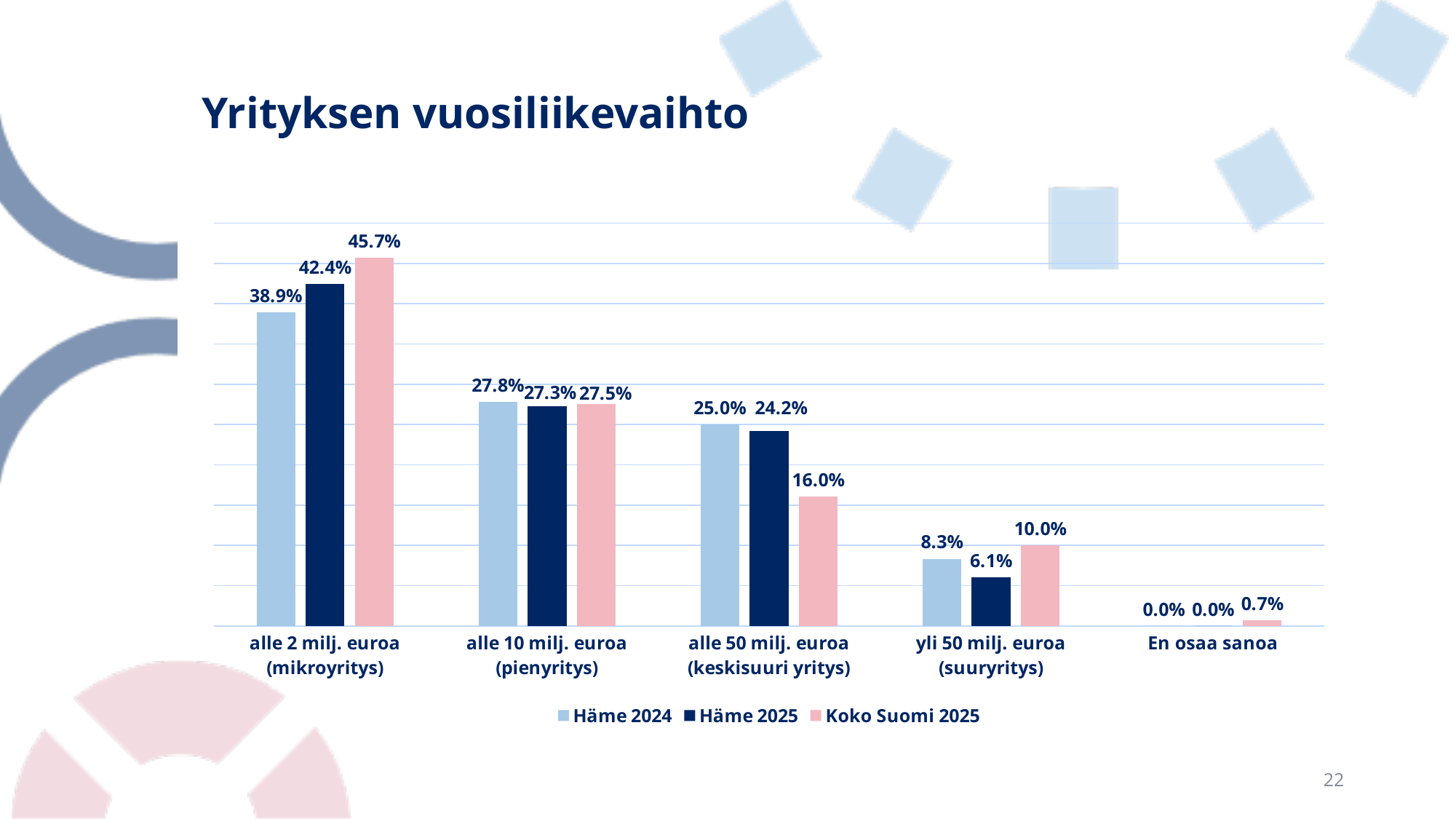
What is the difference between the Koko Suomi 2025 and Häme 2024 values in the 'alle 2 milj. euroa (mikroyritys)' category? 6.8% Which is larger in the 'alle 50 milj. euroa (keskisuuri yritys)' category: Häme 2024 or Häme 2025? Häme 2024 Do the Häme 2025 values rise or fall from 'alle 2 milj. euroa' to 'En osaa sanoa' along the x axis? Fall What is the value for Häme 2024 in the 'alle 2 milj. euroa (mikroyritys)' category? 38.9% What kind of chart is shown on the slide? Bar chart What is the value for Häme 2025 in the 'yli 50 milj. euroa (suuryritys)' category? 6.1% Which category has the highest value for Koko Suomi 2025? alle 2 milj. euroa (mikroyritys) Which category has the lowest value for Häme 2024? En osaa sanoa How many series does the legend list? 3 What is the title of the chart? Yrityksen vuosiliikevaihto What is the value for Koko Suomi 2025 in the 'alle 50 milj. euroa (keskisuuri yritys)' category? 16.0% How many categories are shown on the x axis? 5